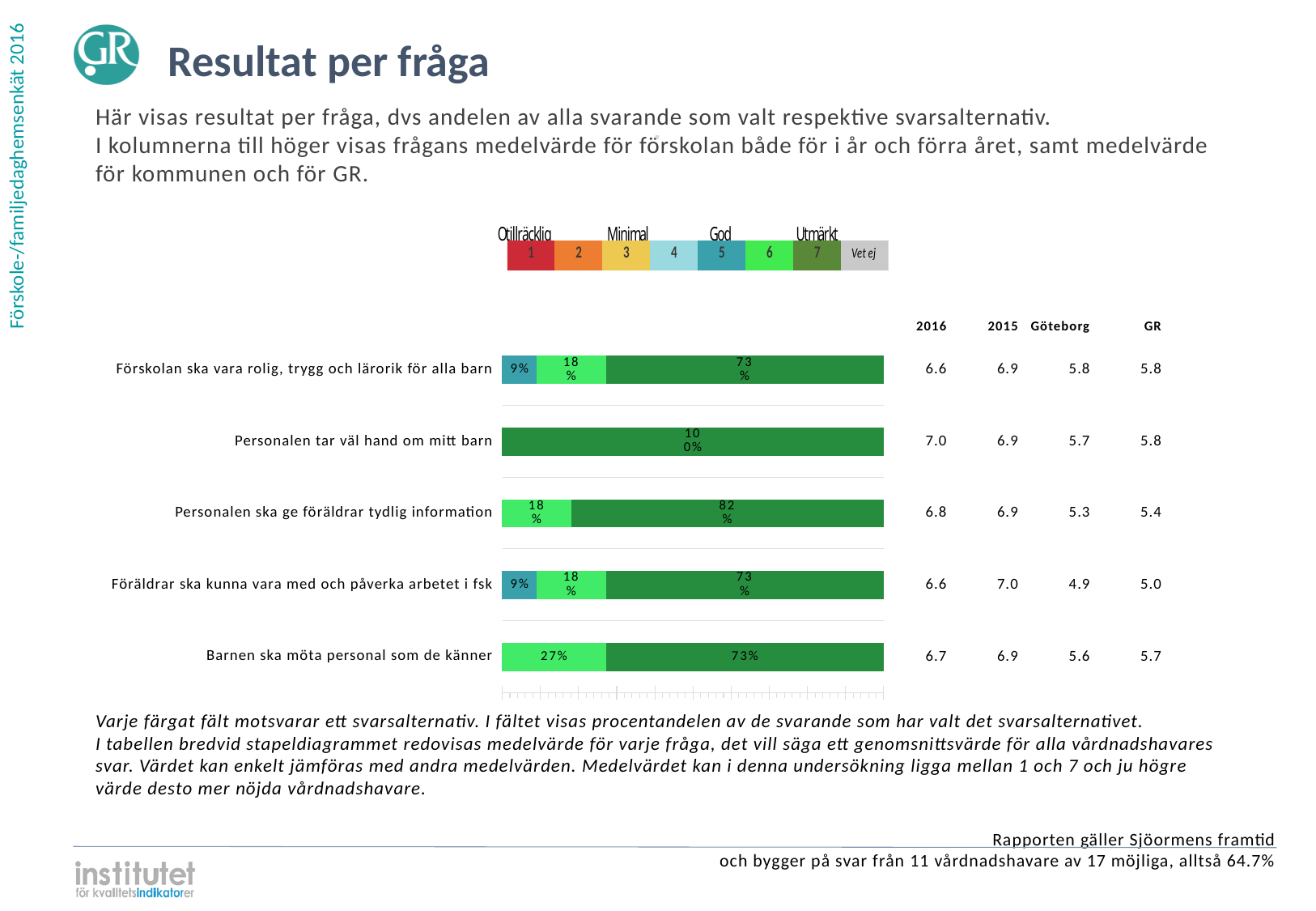
Which question has the largest share of respondents choosing answer option 7? Personalen tar väl hand om mitt barn What percentage of respondents chose answer option 5 for "Förskolan ska vara rolig, trygg och lärorik för alla barn"? 9% What is the 2016 mean value shown for "Personalen tar väl hand om mitt barn"? 7.0 What kind of chart is shown on the slide? stacked bar chart What is the difference between the share choosing option 7 and the share choosing option 6 for "Personalen ska ge föräldrar tydlig information"? 64% How many answer options are listed in the colour legend above the chart, including "Vet ej"? 8 What is the Göteborg mean value shown for "Föräldrar ska kunna vara med och påverka arbetet i fsk"? 4.9 How many questions (categories) are plotted in the bar chart? 5 What percentage of respondents chose answer option 7 for "Personalen ska ge föräldrar tydlig information"? 82% For "Barnen ska möta personal som de känner", which is larger: the share choosing option 6 or the share choosing option 7? option 7 What percentage of respondents chose answer option 7 for "Personalen tar väl hand om mitt barn"? 100% What percentage of respondents chose answer option 6 for "Barnen ska möta personal som de känner"? 27%